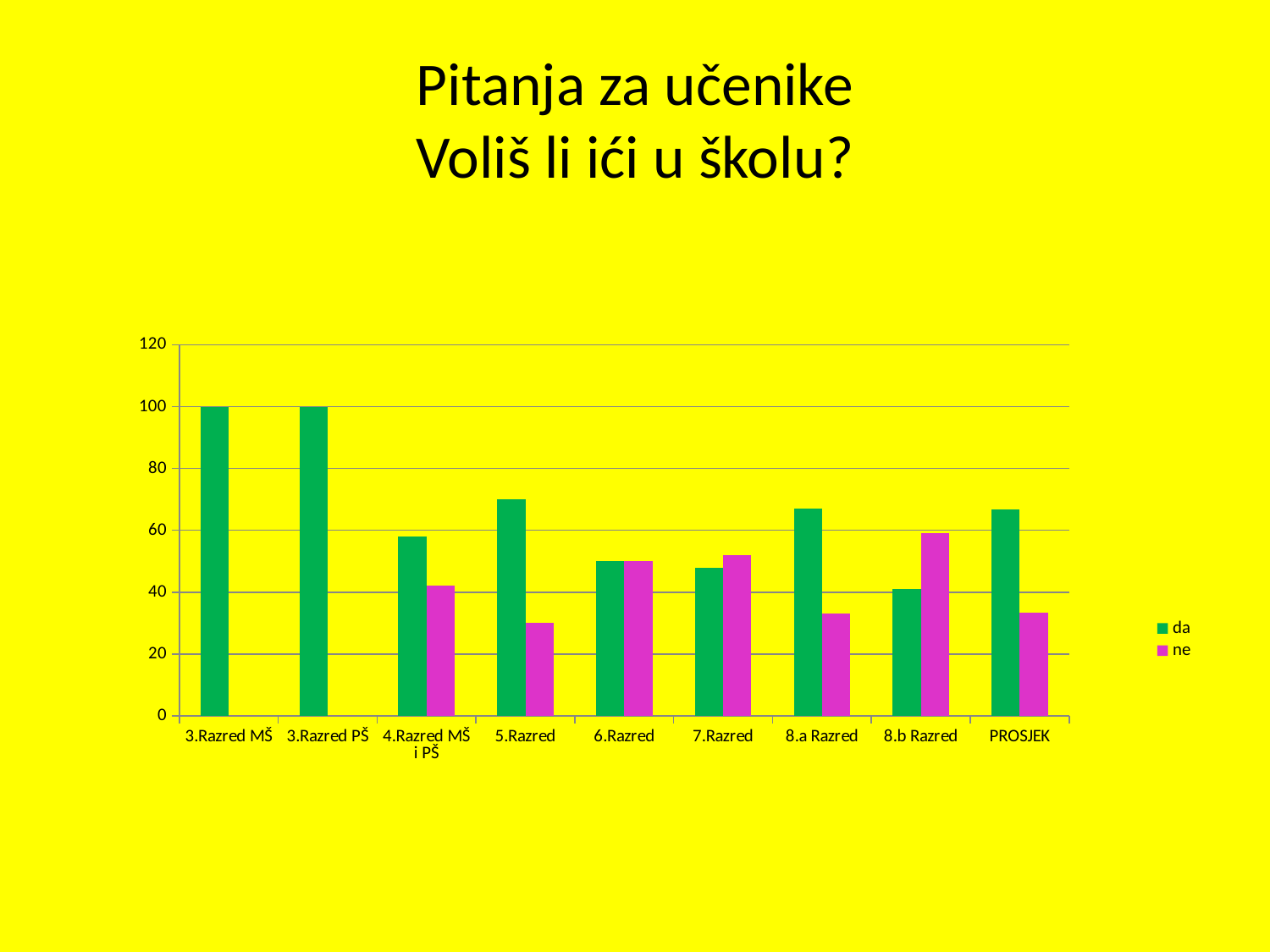
For 8.b Razred, which is larger, "da" or "ne"? ne What is the value of "da" for 3.Razred MŠ? 100 Is the "ne" value for PROSJEK greater or less than 40? less How many categories are shown on the x axis? 9 What is the value of "da" for 3.Razred PŠ? 100 How many series does the legend list? 2 Which category has the lowest "da" value? 8.b Razred For 5.Razred, which is larger, "da" or "ne"? da Is the "da" value for 4.Razred MŠ i PŠ greater or less than 60? less What kind of chart is shown on the slide? bar chart Which category has the highest "ne" value? 8.b Razred Which colour represents the "da" series in the legend? green